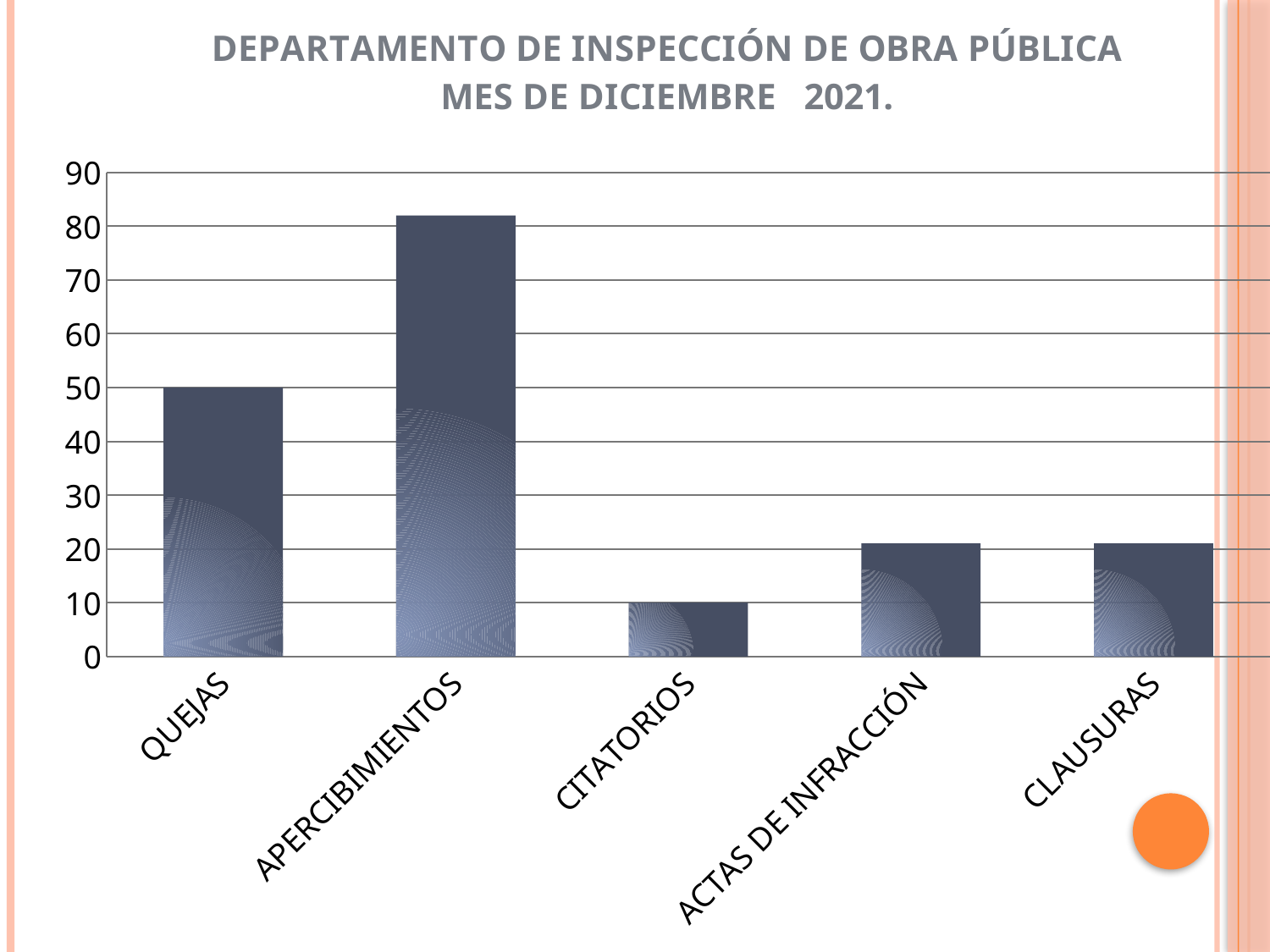
What is the difference between the values for QUEJAS and CITATORIOS? 40 What is the value for CITATORIOS? 10 Which category has the highest value in the chart? APERCIBIMIENTOS Which month and year does the chart title say the data is for? DICIEMBRE 2021 How many categories are shown on the x axis of the chart? 5 What is the value for QUEJAS? 50 Is the value for APERCIBIMIENTOS greater or less than 80? greater What type of chart is shown on the slide? bar chart Which category has the lowest value in the chart? CITATORIOS Which is larger, the value for QUEJAS or the value for ACTAS DE INFRACCIÓN? QUEJAS Is the value for CLAUSURAS greater or less than 30? less